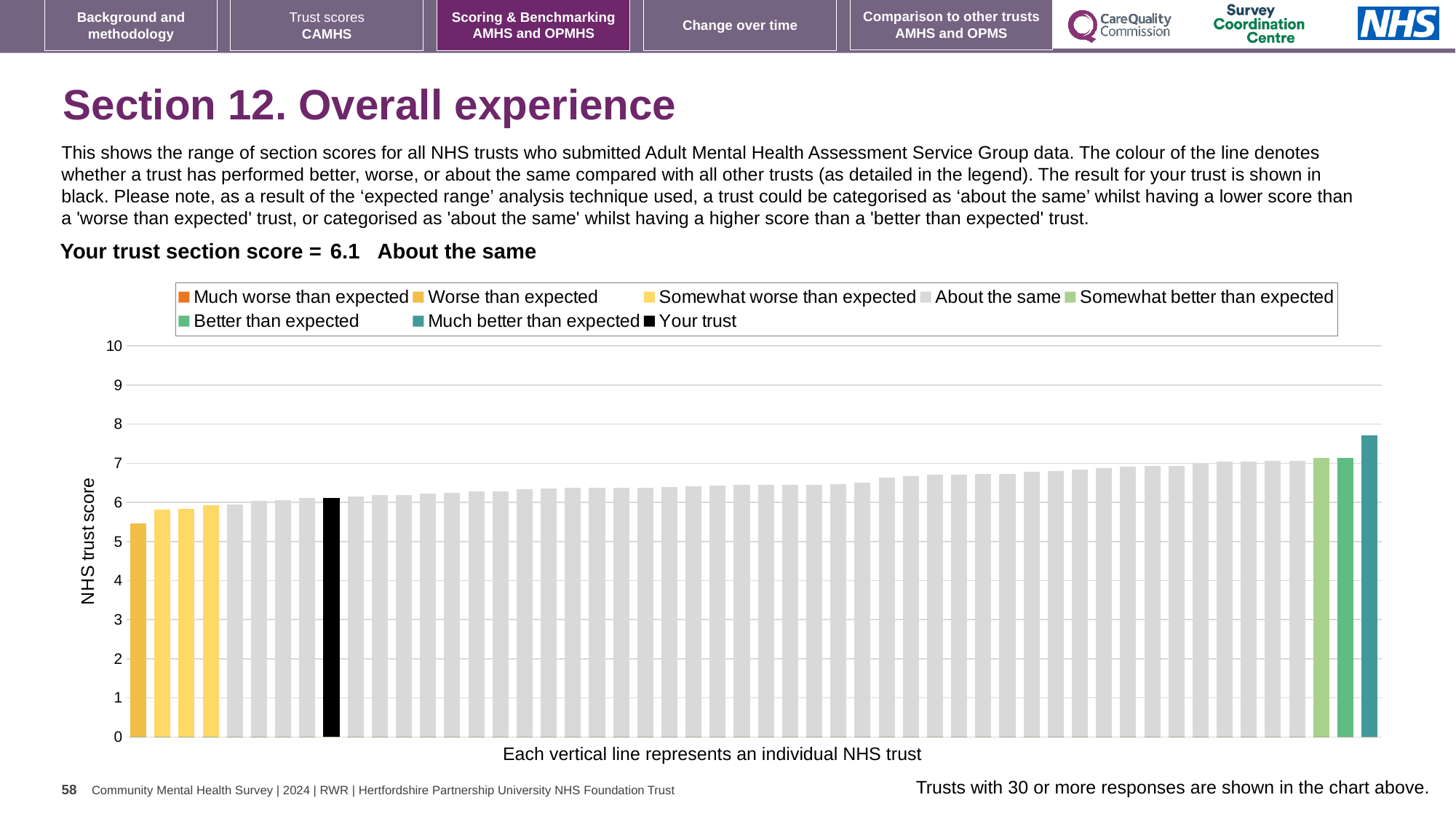
Is the value of the tallest bar greater or less than 8? less How many entries does the chart legend list? 8 What is the label on the vertical axis of the chart? NHS trust score Is the value of the tallest bar greater or less than 7? greater Is the value of the black bar (your trust) greater or less than 7? less What colour is the bar representing your trust? black What kind of chart is shown on the slide? bar chart Which category is your trust's section score placed in? About the same What is the section score for your trust shown on the slide? 6.1 Do the bar values rise or fall from left to right across the chart? rise